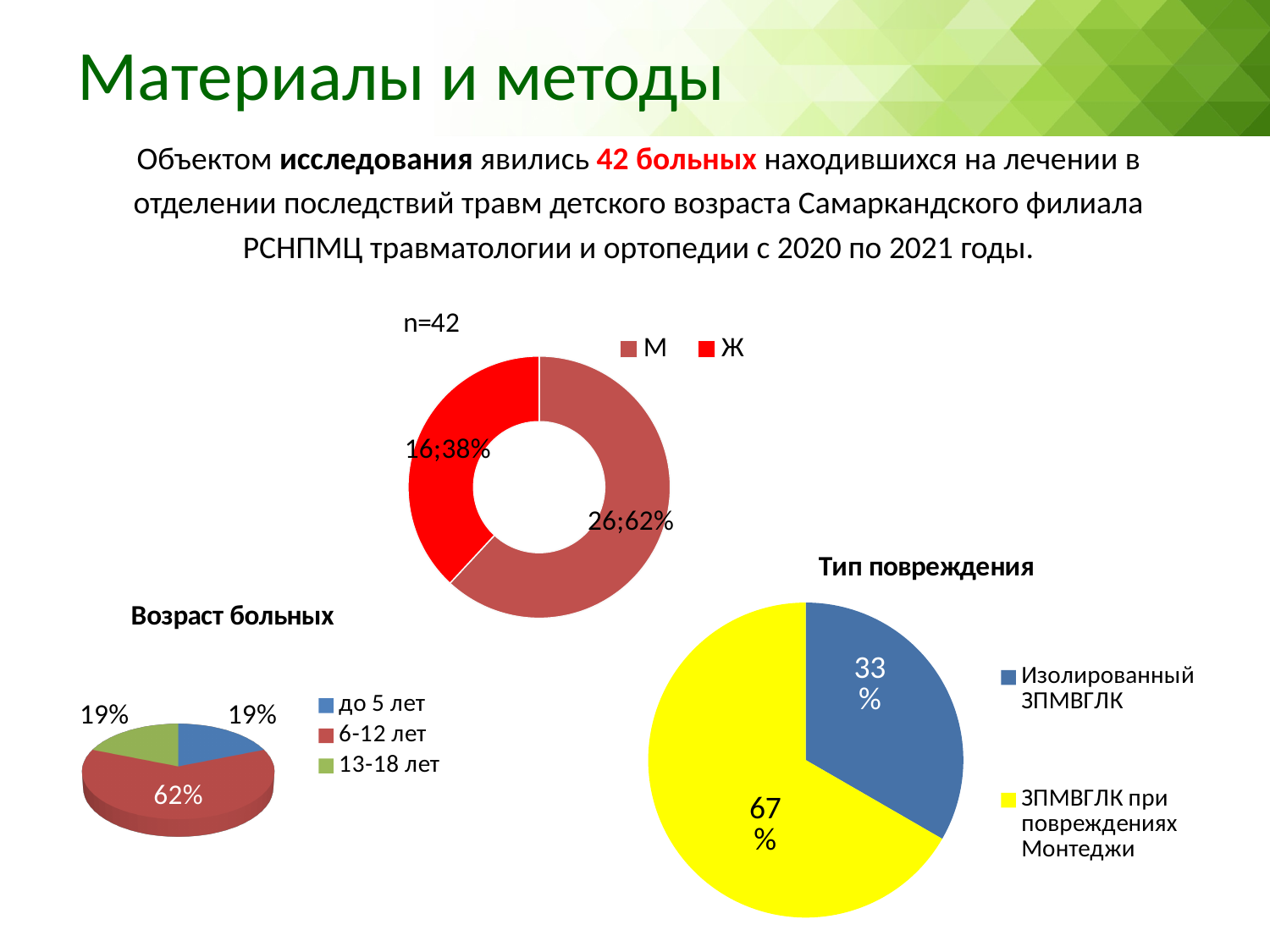
In the chart titled Тип повреждения, which category has the largest share? ЗПМВГЛК при повреждениях Монтеджи In the chart titled Возраст больных, which age group has the largest share? 6-12 лет In the chart titled Возраст больных, how many categories does the legend list? 3 In the doughnut chart labelled n=42, what is the value shown for Ж? 16;38% In the doughnut chart labelled n=42, how many series does the legend list? 2 What kind of chart is the chart titled Тип повреждения? Pie chart In the doughnut chart labelled n=42, which category is larger, М or Ж? М In the doughnut chart labelled n=42, what is the value shown for М? 26;62% In the chart titled Возраст больных, what share is shown for до 5 лет? 19% In the doughnut chart labelled n=42, what is the difference in count between М and Ж? 10 In the chart titled Возраст больных, what share is shown for 6-12 лет? 62% In the chart titled Тип повреждения, what share is shown for Изолированный ЗПМВГЛК? 33%